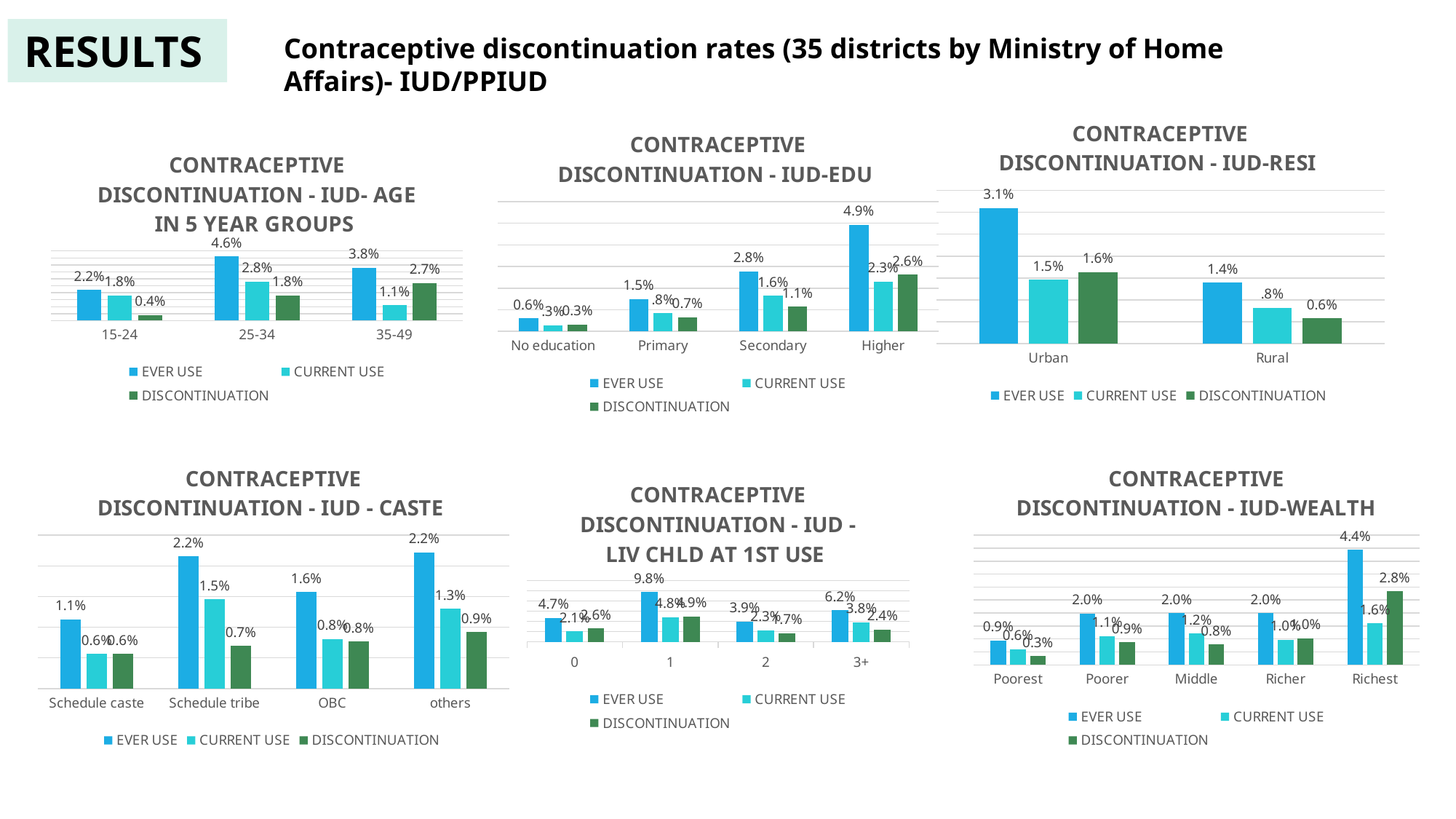
In the IUD - LIV CHLD AT 1ST USE chart, what is the DISCONTINUATION value for 2? 1.7% How many charts are shown on the slide? 6 How many categories are shown on the x axis of the IUD-WEALTH chart? 5 In the IUD - CASTE chart, which is larger: the CURRENT USE value for Schedule tribe or for OBC? Schedule tribe In the IUD - LIV CHLD AT 1ST USE chart, what is the difference between the EVER USE values for 1 and 3+? 3.6% In the IUD-EDU chart, what is the DISCONTINUATION value for Higher? 2.6% In the IUD- AGE IN 5 YEAR GROUPS chart, which age group has the highest EVER USE value? 25-34 How many series does the legend of the IUD-RESI chart list? 3 What kind of chart is the IUD - CASTE chart? Bar chart In the IUD-RESI chart, what is the EVER USE value for Urban? 3.1% In the IUD-EDU chart, do the EVER USE values rise or fall from No education to Higher? Rise In the IUD-WEALTH chart, which wealth group has the lowest DISCONTINUATION value? Poorest